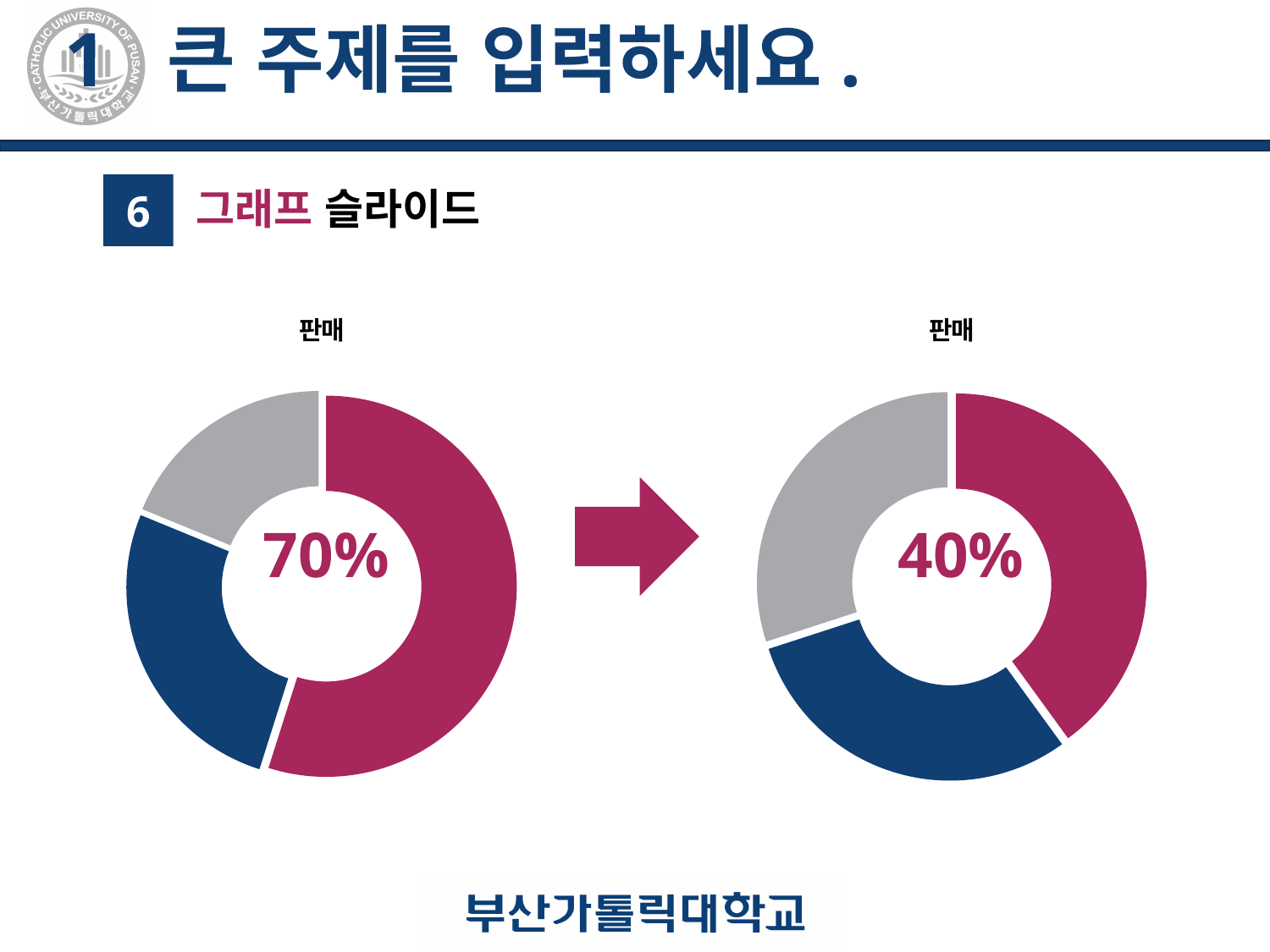
In the right chart, which coloured slice is the largest? the magenta slice In the right chart, how many slices does the doughnut have? 3 In the left chart, which coloured slice is the largest? the magenta slice How many charts are shown on the slide? 2 In the left chart, how many slices does the doughnut have? 3 What kind of chart is the left chart titled 판매? doughnut chart In the left chart, which coloured slice is the smallest? the grey slice In the right chart, what percentage is printed in the centre of the doughnut? 40% In the left chart, what percentage is printed in the centre of the doughnut? 70% What is the title of the left chart? 판매 What is the difference between the centre percentage of the left chart and that of the right chart? 30% Which chart shows the larger centre percentage, the left chart or the right chart? the left chart